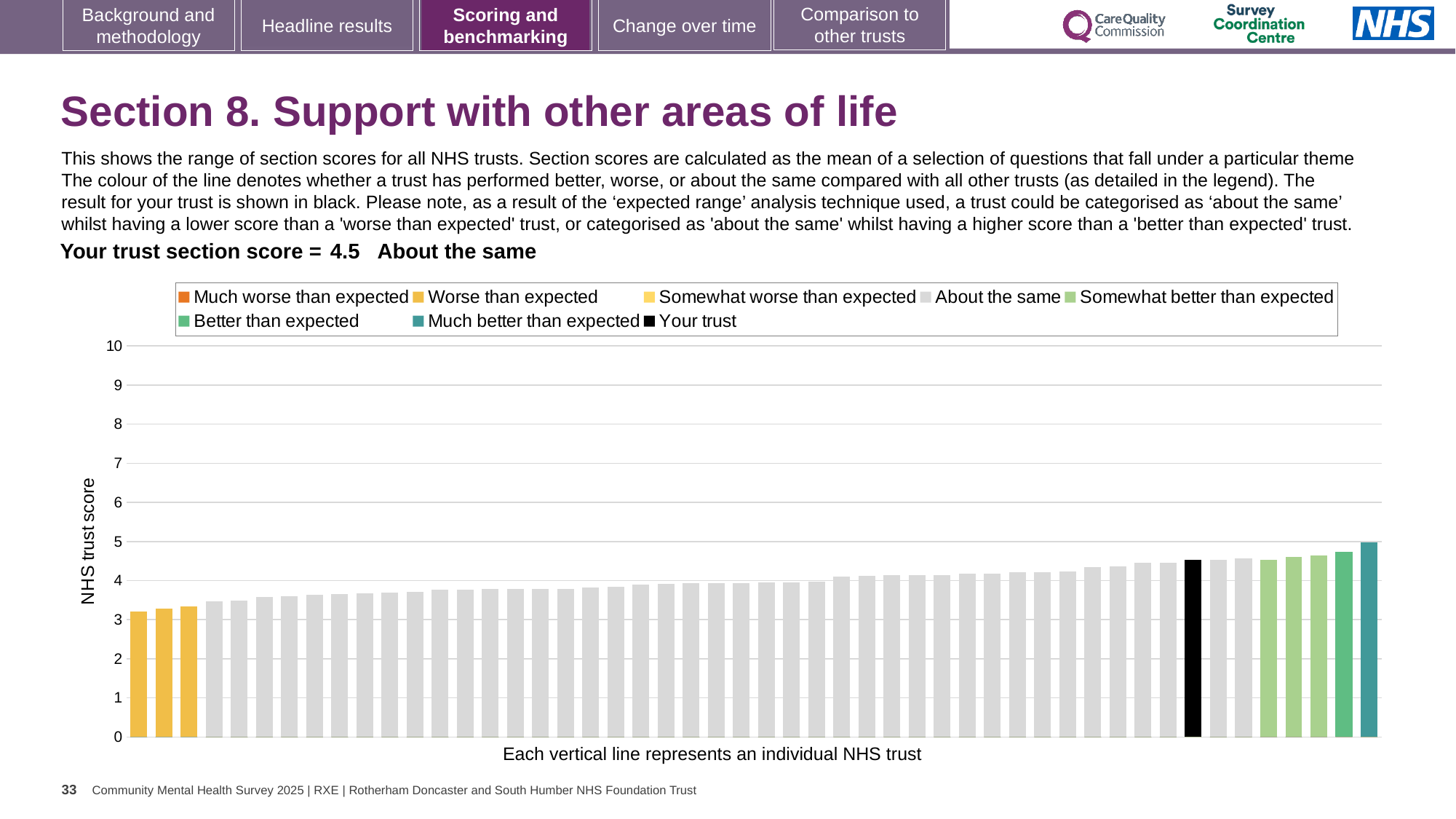
What is the label on the y axis of the chart? NHS trust score How many bars are coloured as 'Much better than expected'? 1 Is the value of the highest bar in the chart greater or less than 6? less Do the bar values rise or fall from left to right along the x axis? rise Is the value of the black 'Your trust' bar greater or less than 4? greater What is the section score for your trust? 4.5 Is the value of the lowest bar in the chart greater or less than 4? less What kind of chart is shown on the slide? bar chart How many bars are coloured as 'Worse than expected'? 3 How many entries does the chart legend list? 8 Which legend category does the highest bar in the chart belong to? Much better than expected Which legend category does the lowest bar in the chart belong to? Worse than expected